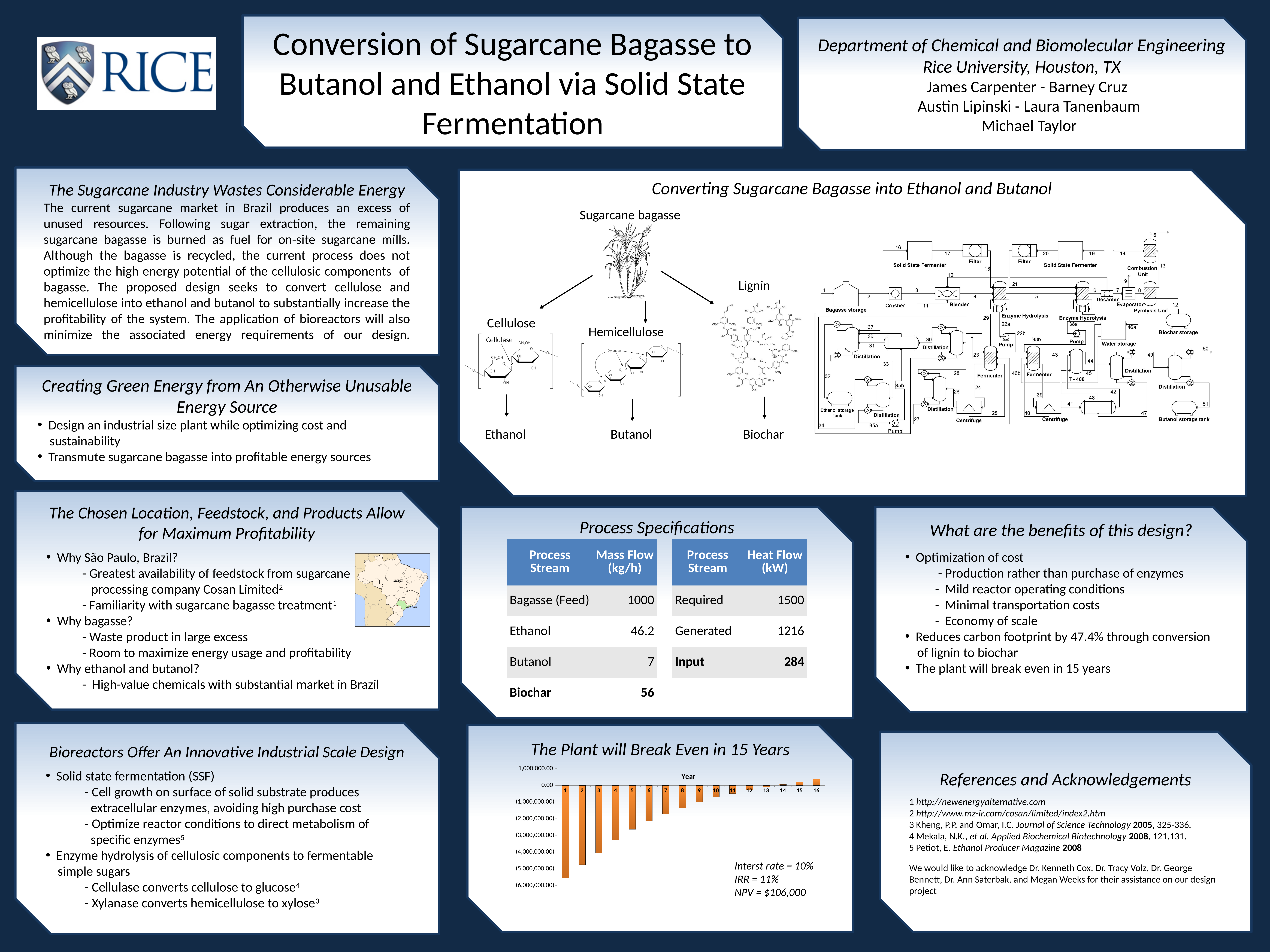
In the break-even chart, is the value for year 16 greater or less than 0.00? greater What is the label on the x axis of the break-even chart? Year In the break-even chart, which is larger, the value for year 1 or the value for year 8? Year 8 In the break-even chart, do the values generally rise or fall from year 1 to year 16? rise In the break-even chart, is the value for year 1 greater or less than (5,000,000.00)? less What IRR is stated in the annotation on the break-even chart? 11% In the break-even chart, which year has the lowest (most negative) value? Year 1 In the break-even chart, which is larger, the value for year 6 or the value for year 16? Year 16 In the break-even chart, is the value for year 12 greater or less than (1,000,000.00)? greater What kind of chart is shown under the title 'The Plant will Break Even in 15 Years'? bar chart How many years (bars) are plotted on the x axis of the break-even chart? 16